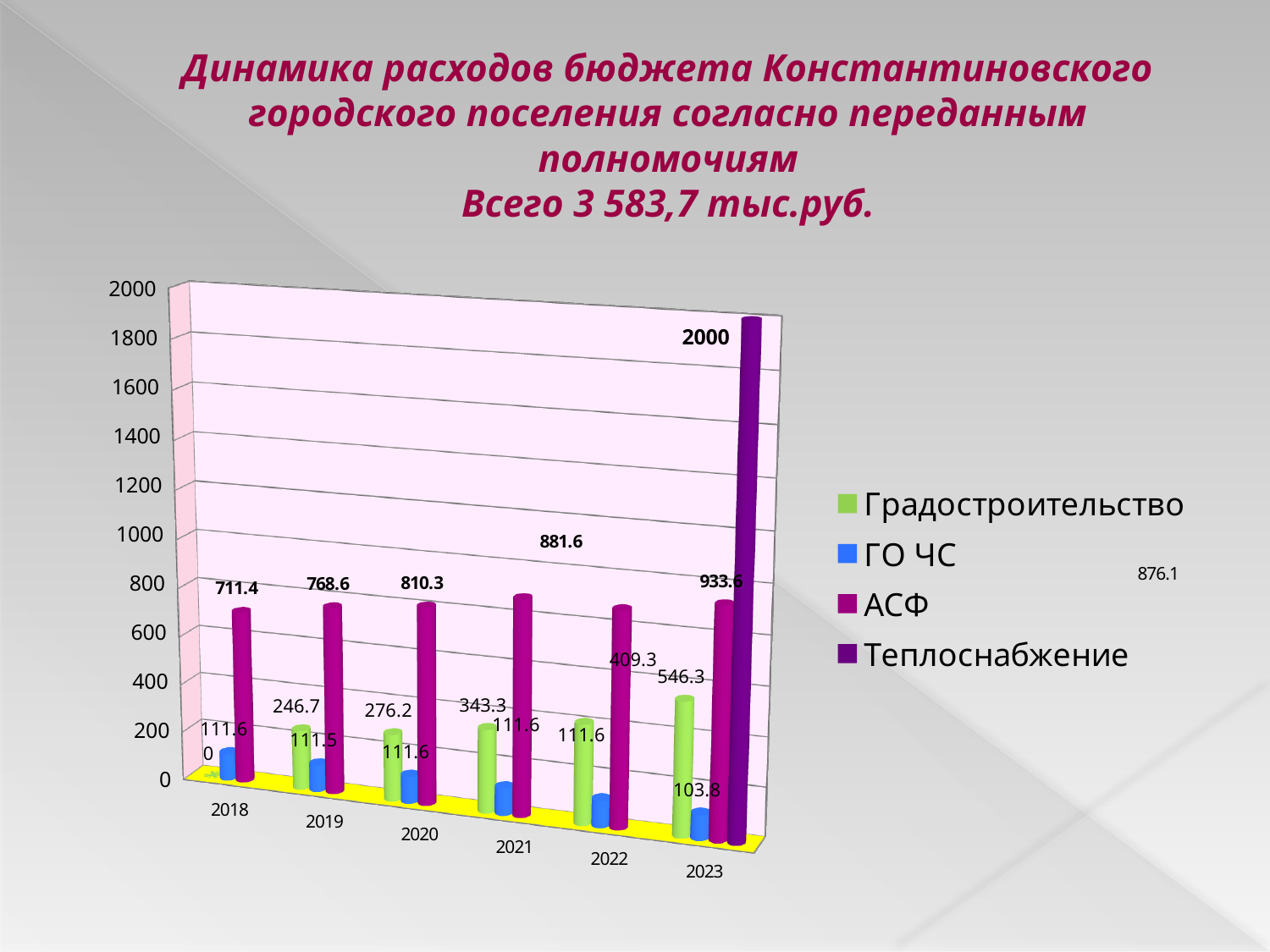
What kind of chart is shown on the slide? bar chart Do the values for АСФ rise or fall from 2018 to 2021? rise What is the difference between the Градостроительство values for 2023 and 2022? 137 How many years are shown on the x axis? 6 What is the value for Теплоснабжение in 2023? 2000 In which year is the value for Градостроительство highest? 2023 What is the value for ГО ЧС in 2023? 103.8 Which series is shown in dark purple in the legend? Теплоснабжение What is the value for Градостроительство in 2018? 0 How many series does the legend list? 4 What is the value for АСФ in 2018? 711.4 What is the value for Градостроительство in 2023? 546.3